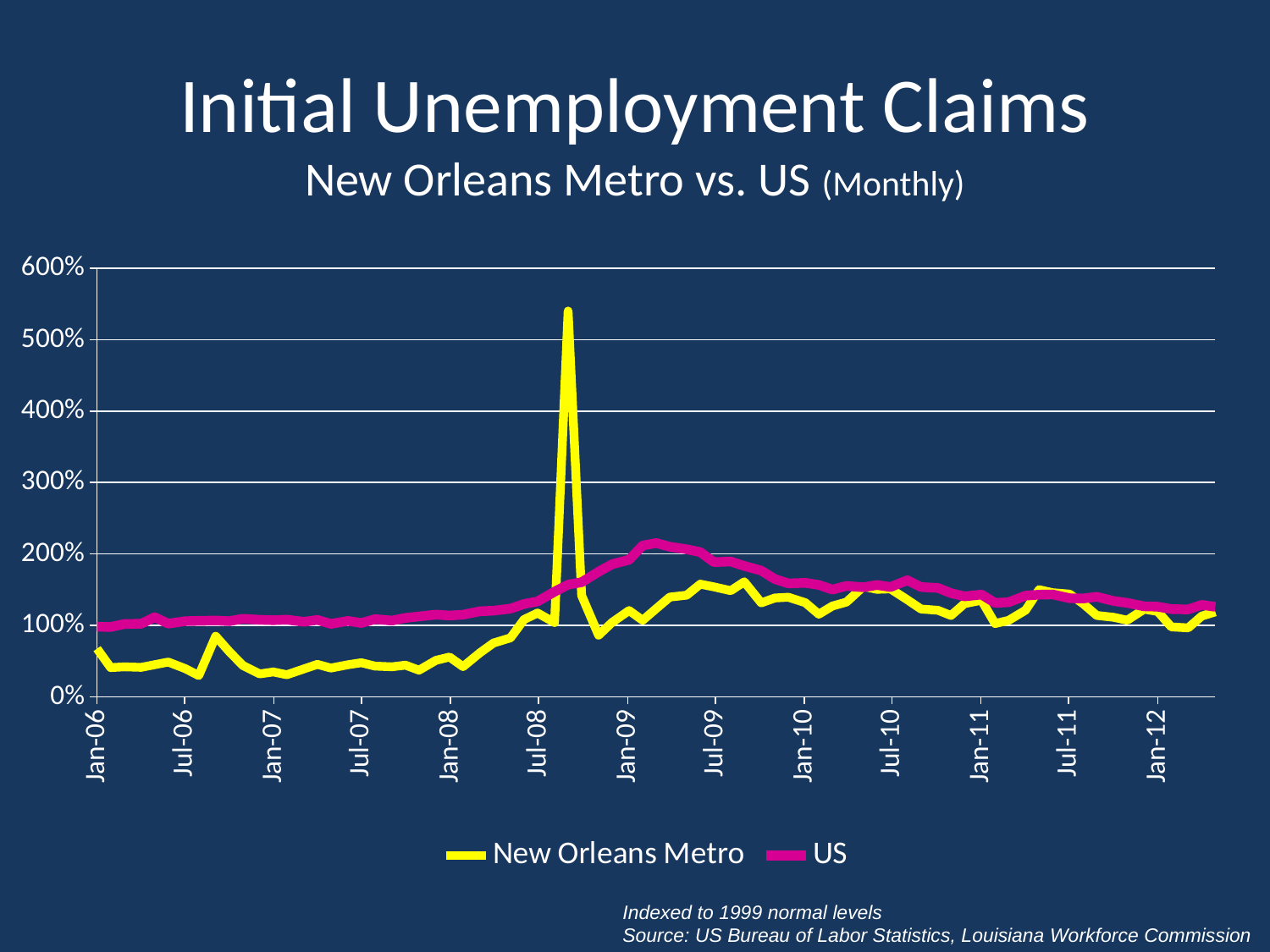
Is the peak value of the New Orleans Metro series greater or less than 500%? greater What is the highest value shown on the vertical axis? 600% Does the US series rise or fall between Jan-08 and Jan-09? Rise Which two series are listed in the legend? New Orleans Metro and US What kind of chart is shown on the slide? Line chart Is the value for New Orleans Metro at Jan-08 greater or less than 100%? less Which series reaches the highest value anywhere on the chart? New Orleans Metro How many series does the legend list? 2 Is the value for US at Jan-09 greater or less than 150%? greater At Jan-07, which series has the higher value, New Orleans Metro or US? US